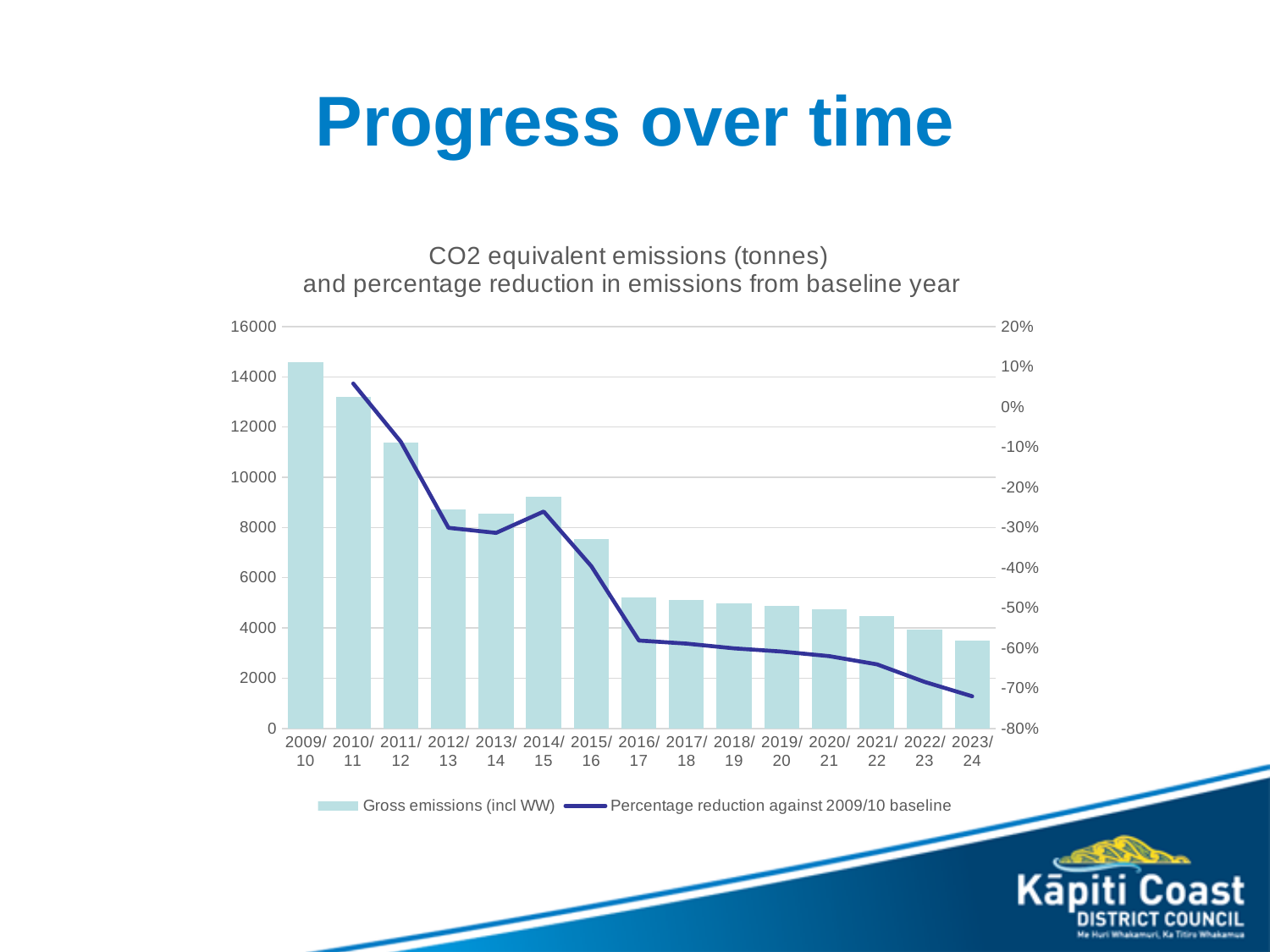
Is the gross emissions value for 2014/15 greater or less than 8000? greater Which year has higher gross emissions, 2013/14 or 2014/15? 2014/15 Do gross emissions generally rise or fall from 2009/10 to 2023/24? Fall How many years (categories) are shown on the x axis? 15 Is the percentage reduction against the 2009/10 baseline for 2016/17 greater or less than -50%? less What is the title of the chart? CO2 equivalent emissions (tonnes) and percentage reduction in emissions from baseline year Is the gross emissions value for 2009/10 greater or less than 14000? greater Which year has the lowest gross emissions bar? 2023/24 What kind of chart is shown on the slide? A combined bar and line chart Which year has the highest gross emissions bar? 2009/10 How many series does the legend list? 2